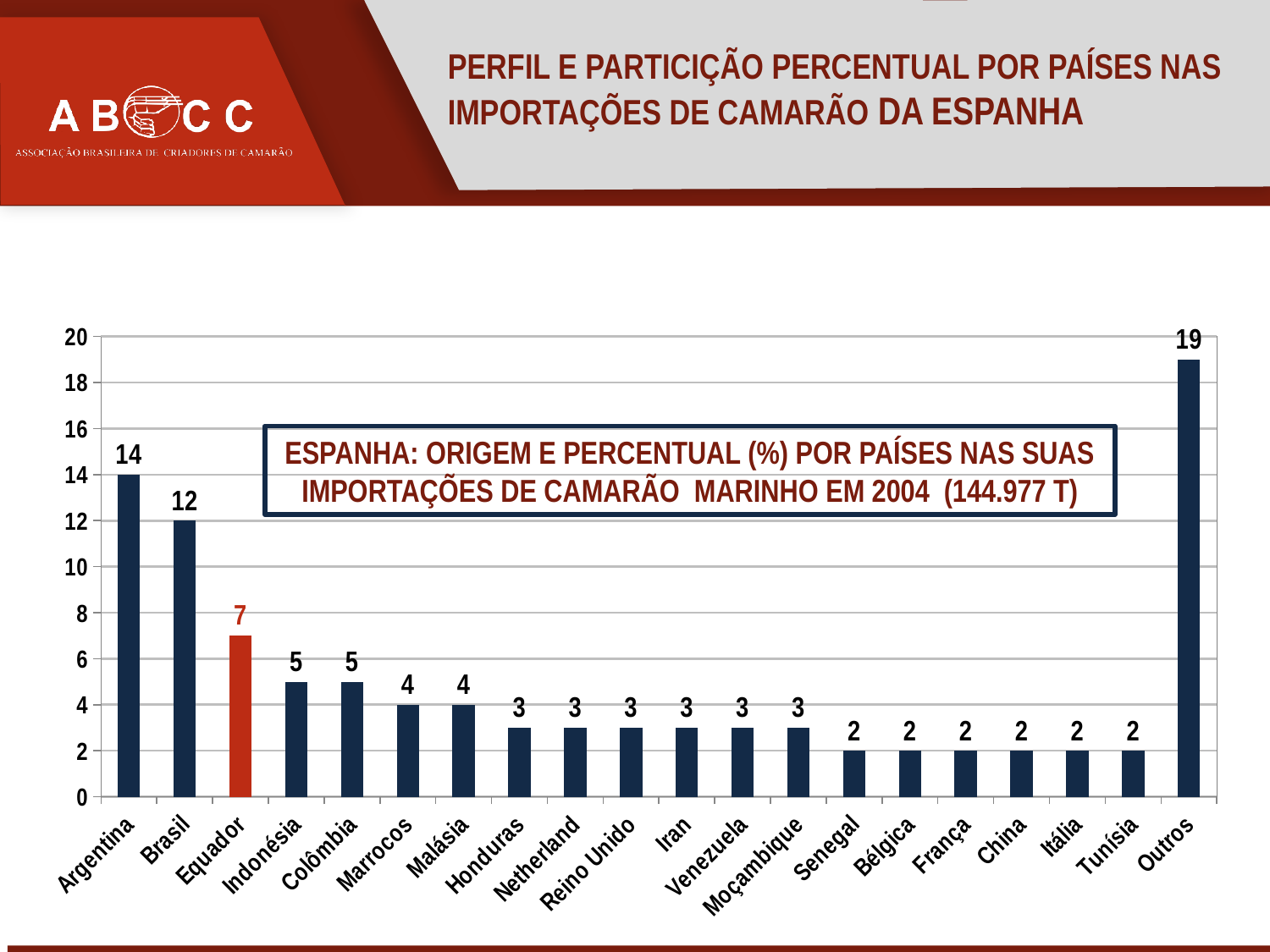
What is the value for Moçambique? 3 How many categories are shown on the x axis? 20 Which is larger, the value for Indonésia or the value for Marrocos? Indonésia Which category's bar is coloured red instead of dark blue? Equador According to the chart's title box, which year do the data refer to? 2004 What is the value for Argentina? 14 What is the difference between the values for Argentina and Brasil? 2 Which category has the highest value? Outros What is the value for Outros? 19 What is the value for Equador? 7 What kind of chart is shown on the slide? bar chart What is the difference between the values for Outros and Argentina? 5